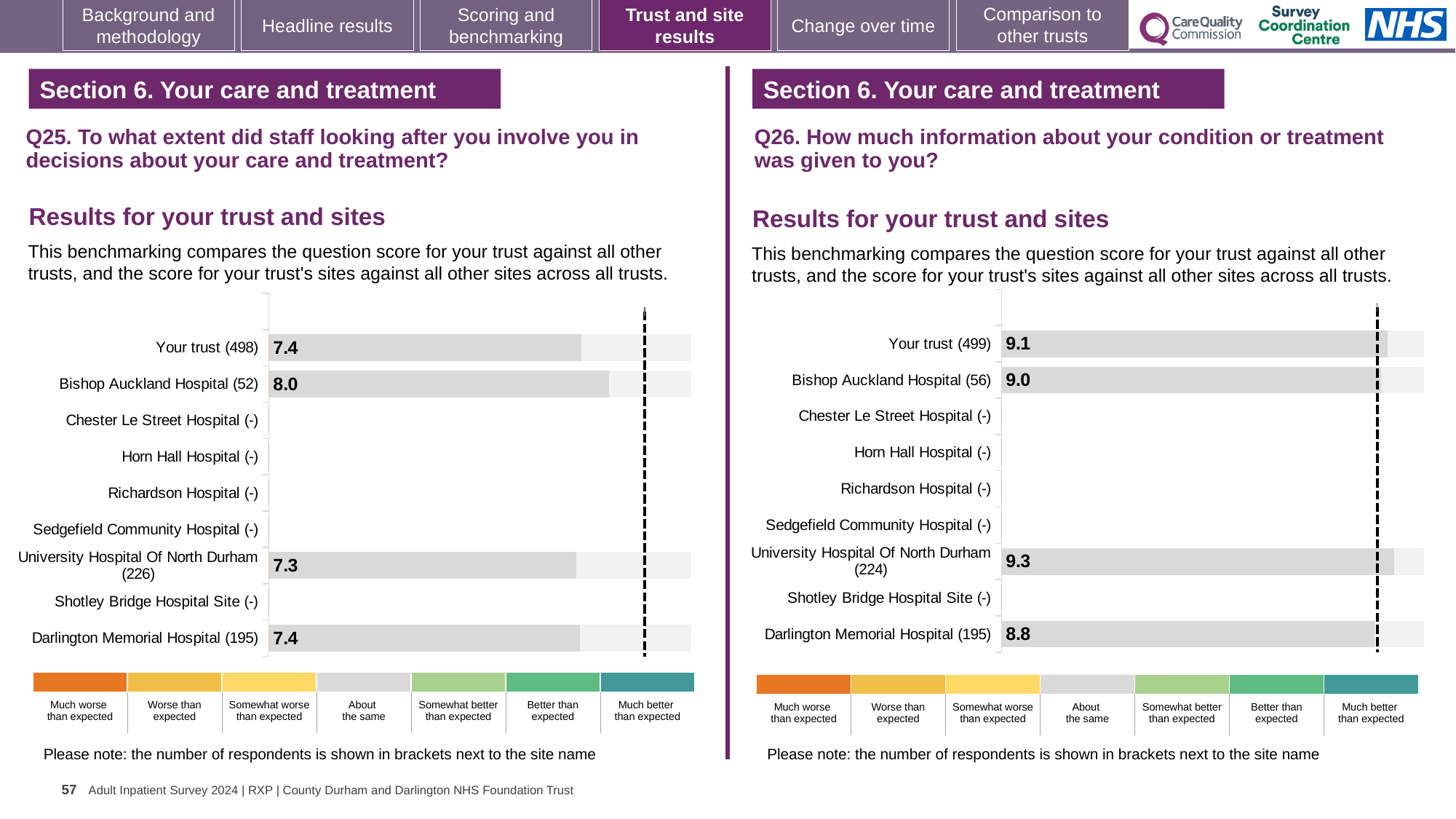
On the Q26 chart (right), which site has the lowest score among those with a score shown? Darlington Memorial Hospital On the Q25 chart (left), what is the score for University Hospital Of North Durham? 7.3 On the Q25 chart (left), what is the score for Bishop Auckland Hospital? 8.0 On the Q25 chart (left), what is the difference between the scores for Bishop Auckland Hospital and University Hospital Of North Durham? 0.7 On the Q25 chart (left), which site has the highest score? Bishop Auckland Hospital On the Q26 chart (right), what is the difference between the scores for University Hospital Of North Durham and Darlington Memorial Hospital? 0.5 On the Q25 chart (left), how many respondents are shown for Your trust? 498 How many site rows (including Your trust) are listed on the Q25 chart (left)? 9 On the Q26 chart (right), what is the score for Your trust? 9.1 What kind of chart is used on the Q26 chart (right)? Bar chart On the Q26 chart (right), what is the score for Darlington Memorial Hospital? 8.8 On the Q26 chart (right), which is larger: the score for University Hospital Of North Durham or for Bishop Auckland Hospital? University Hospital Of North Durham